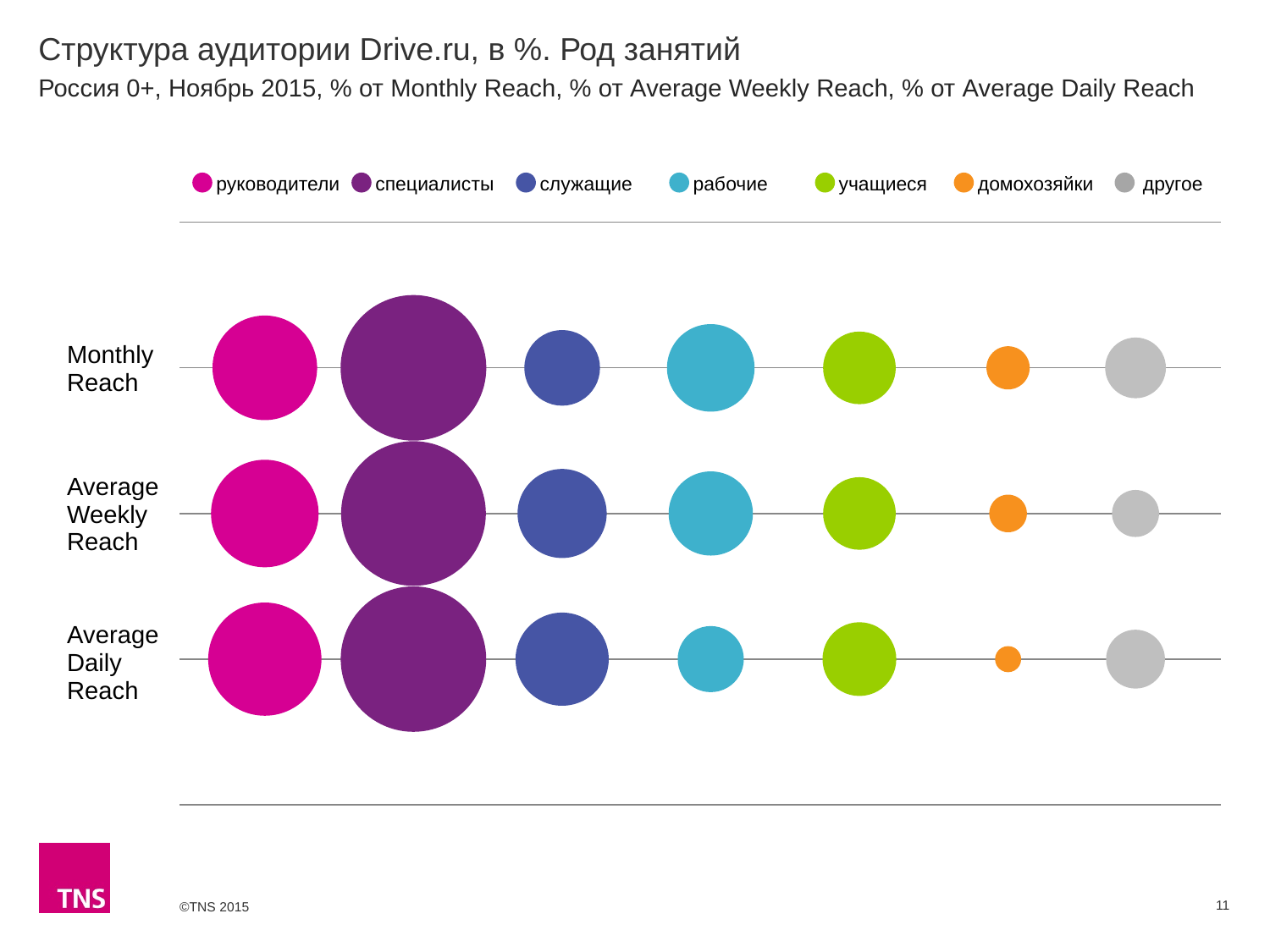
What is the title of the chart on the slide? Структура аудитории Drive.ru, в %. Род занятий Which occupation group has the smallest bubble in the Average Daily Reach row? домохозяйки For домохозяйки, which bubble is larger: Monthly Reach or Average Daily Reach? Monthly Reach Which occupation group has the largest bubble in the Monthly Reach row? специалисты How many series does the legend list? 7 Which occupation group has the largest bubble in the Average Daily Reach row? специалисты How many reach categories (rows) are plotted in the chart? 3 Which legend entry is shown in orange? домохозяйки In the Monthly Reach row, which bubble is larger: руководители or служащие? руководители For рабочие, which bubble is larger: Monthly Reach or Average Daily Reach? Monthly Reach Which occupation group has the smallest bubble in the Monthly Reach row? домохозяйки What kind of chart is shown on the slide? bubble chart